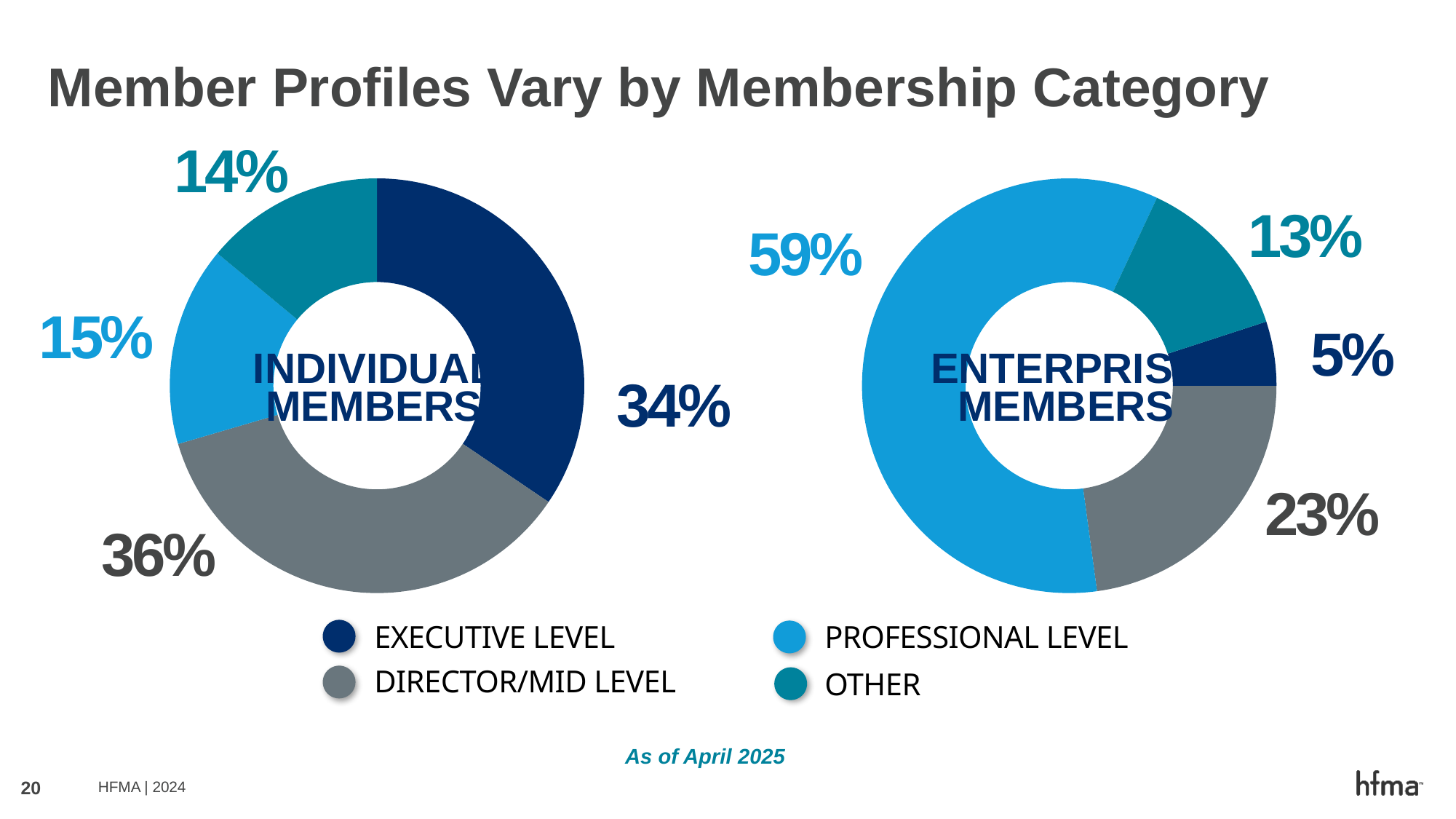
In the Individual Members chart, what share of members are Director/Mid Level? 36% How many categories does the legend list? 4 What is the difference between the Professional Level share in the Enterprise Members chart and the Professional Level share in the Individual Members chart? 44 percentage points In the Individual Members chart, which category has the smallest share? Other In the Enterprise Members chart, what share of members are Executive Level? 5% In the Enterprise Members chart, which category has the largest share? Professional Level In the Enterprise Members chart, what share of members are Professional Level? 59% In the Enterprise Members chart, which category has the smallest share? Executive Level In the Individual Members chart, which is larger: the Director/Mid Level share or the Executive Level share? Director/Mid Level What kind of chart is used for the Individual Members data? Pie (doughnut) chart What is the title of the slide? Member Profiles Vary by Membership Category In the Individual Members chart, what share of members are Executive Level? 34%